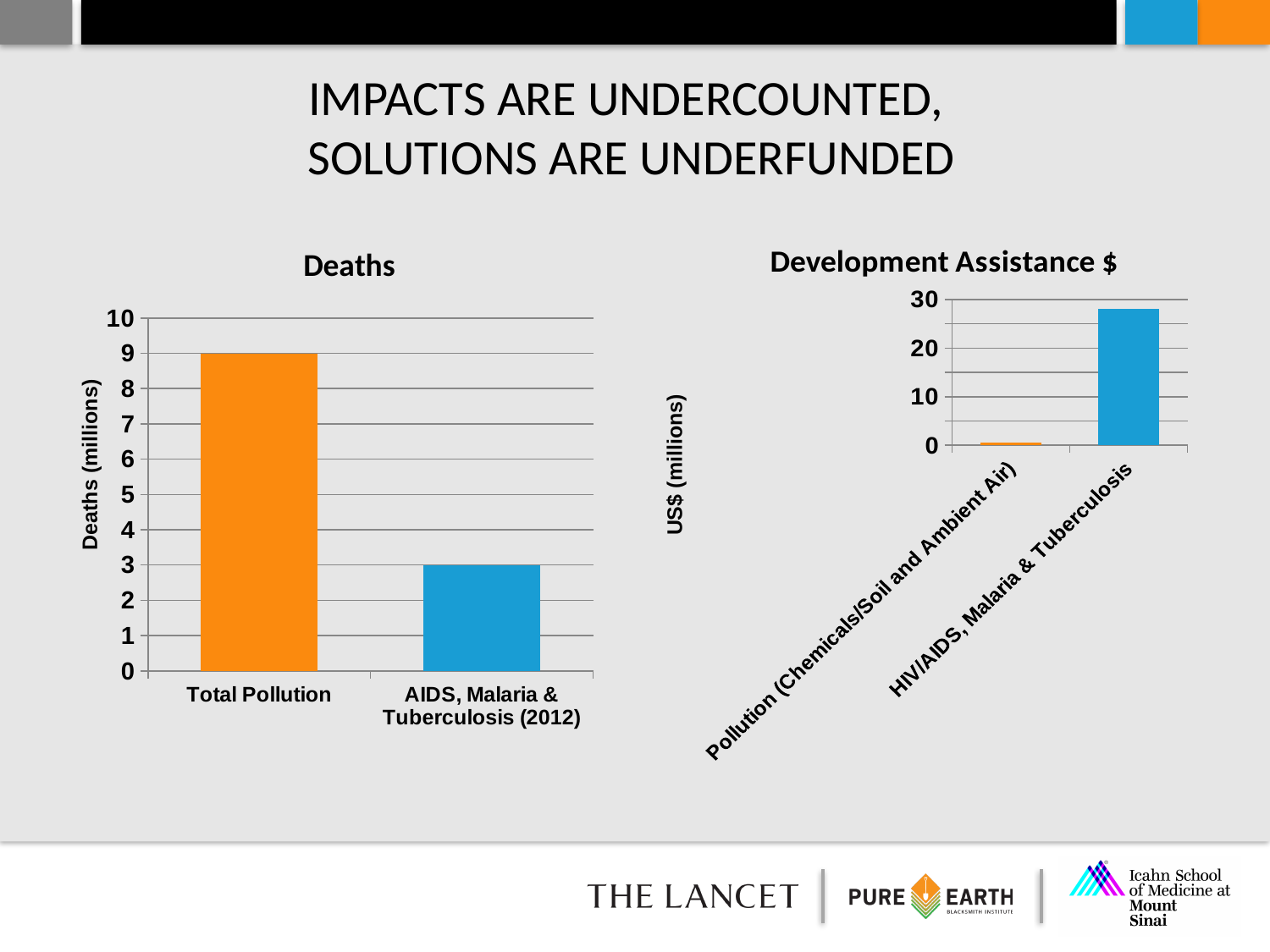
What is the y-axis label of the Development Assistance $ chart? US$ (millions) In the Development Assistance $ chart, is the value for HIV/AIDS, Malaria & Tuberculosis greater or less than 20? greater In the Development Assistance $ chart, is the value for Pollution (Chemicals/Soil and Ambient Air) greater or less than 10? less In the Development Assistance $ chart, which category has the highest value? HIV/AIDS, Malaria & Tuberculosis In the Deaths chart, which category has the lowest value? AIDS, Malaria & Tuberculosis (2012) In the Deaths chart, what is the value for Total Pollution? 9 In the Deaths chart, what is the difference between Total Pollution and AIDS, Malaria & Tuberculosis (2012)? 6 In the Development Assistance $ chart, which is larger: Pollution (Chemicals/Soil and Ambient Air) or HIV/AIDS, Malaria & Tuberculosis? HIV/AIDS, Malaria & Tuberculosis In the Deaths chart, which category has the highest value? Total Pollution In the Deaths chart, what is the value for AIDS, Malaria & Tuberculosis (2012)? 3 In the Deaths chart, how many categories are shown? 2 What kind of chart is the Deaths chart? Bar chart